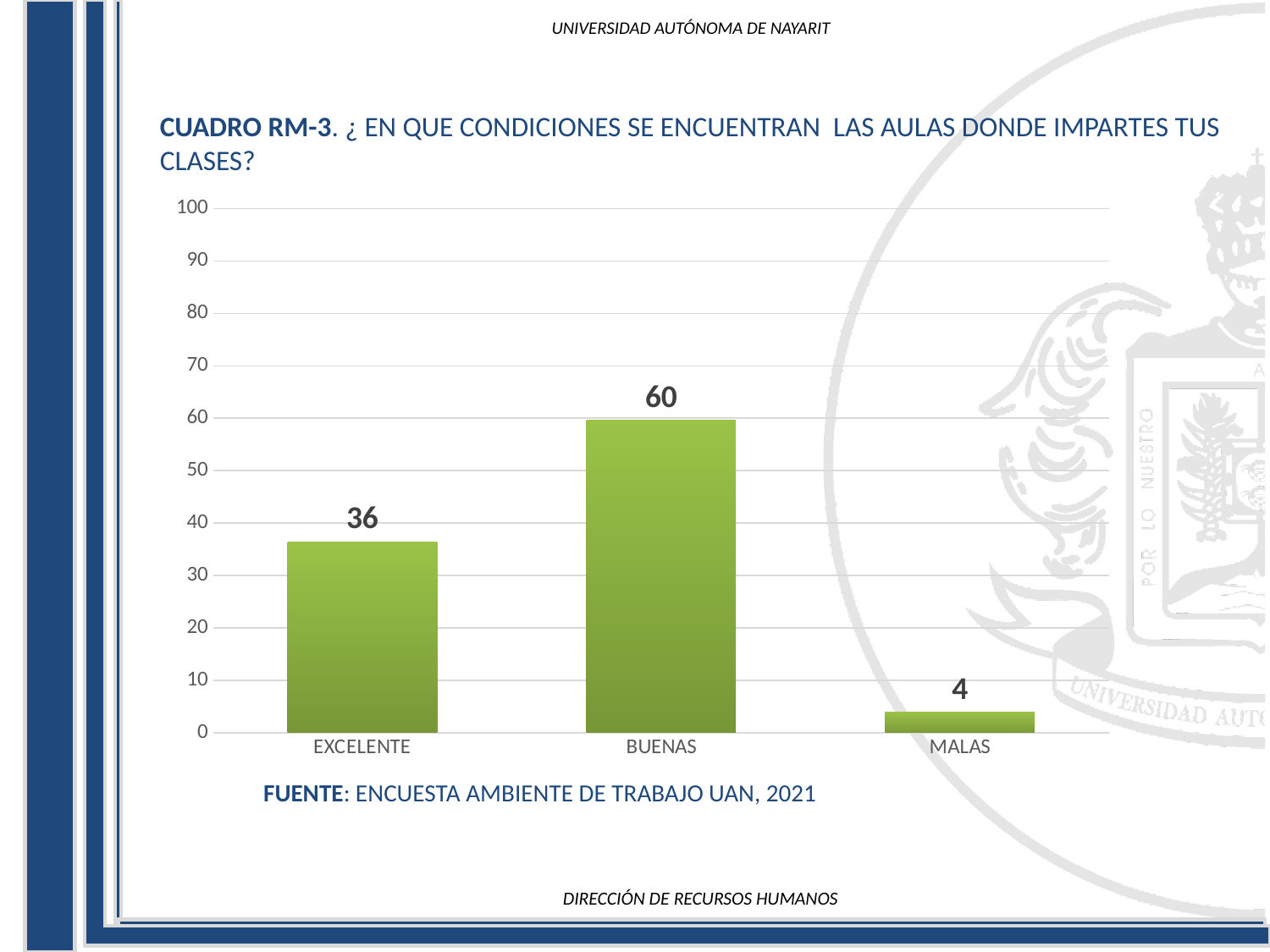
What is the value for BUENAS? 60 What kind of chart is shown on the slide? bar chart What is the difference between the values for EXCELENTE and MALAS? 32 What is the value for MALAS? 4 Is the value for EXCELENTE greater or less than 40? less Which category has the lowest value? MALAS How many categories are shown on the x axis? 3 What is the value for EXCELENTE? 36 Which is larger, the value for EXCELENTE or the value for MALAS? EXCELENTE Which category has the highest value? BUENAS What is the difference between the values for BUENAS and EXCELENTE? 24 What source is cited below the chart? ENCUESTA AMBIENTE DE TRABAJO UAN, 2021